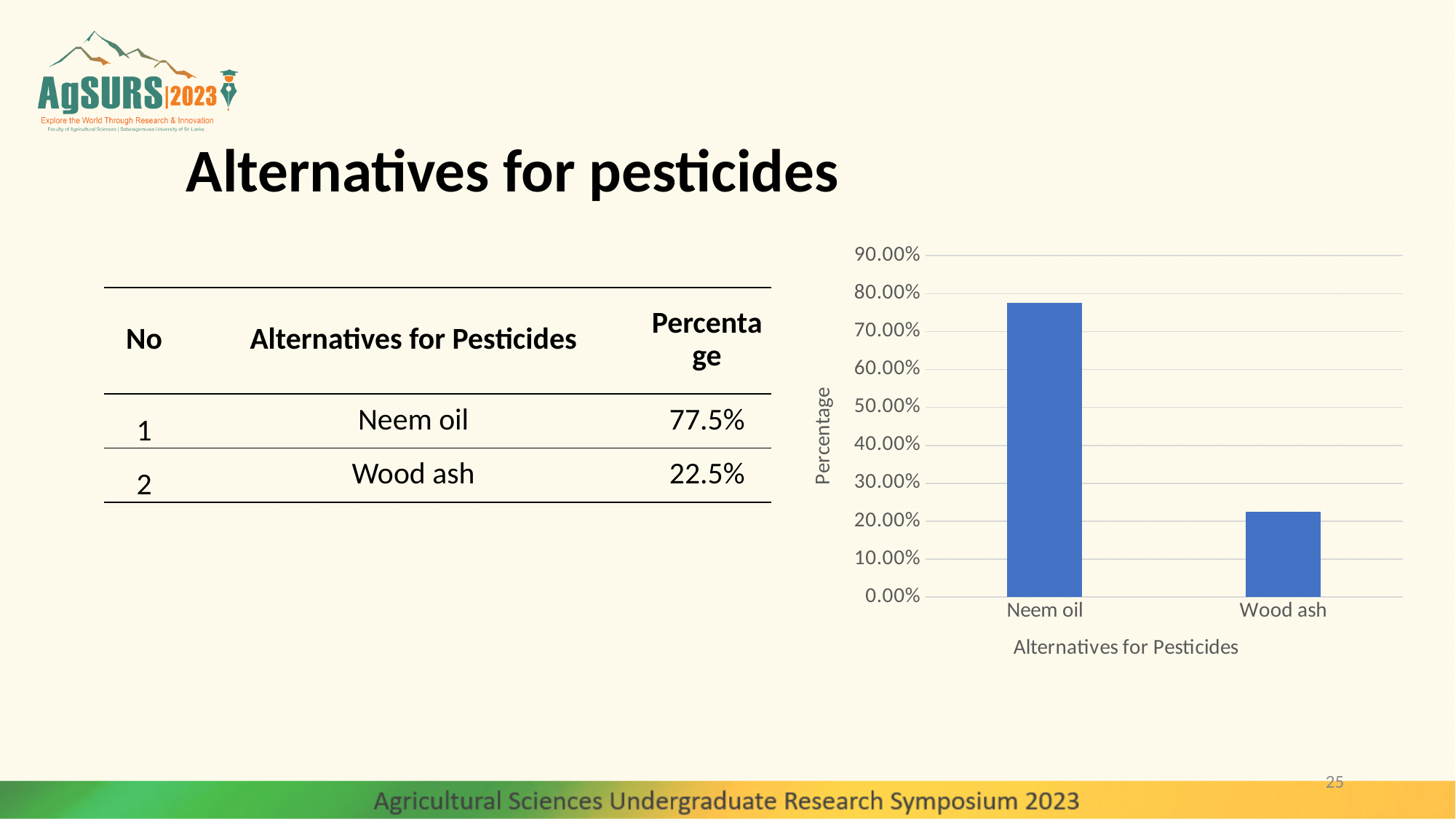
Is the value for Wood ash greater or less than 20.00%? greater Which alternative for pesticides has the highest percentage in the chart? Neem oil How many categories are plotted on the x axis of the chart? 2 Is the value for Neem oil greater or less than 70.00%? greater What is the label of the chart's y axis? Percentage What is the percentage for Wood ash, as given on the slide? 22.5% What kind of chart is shown on the slide? bar chart Is the value for Wood ash greater or less than 30.00%? less Which alternative for pesticides has the lowest percentage in the chart? Wood ash Which is larger, the value for Neem oil or the value for Wood ash? Neem oil What is the percentage for Neem oil, as given on the slide? 77.5%